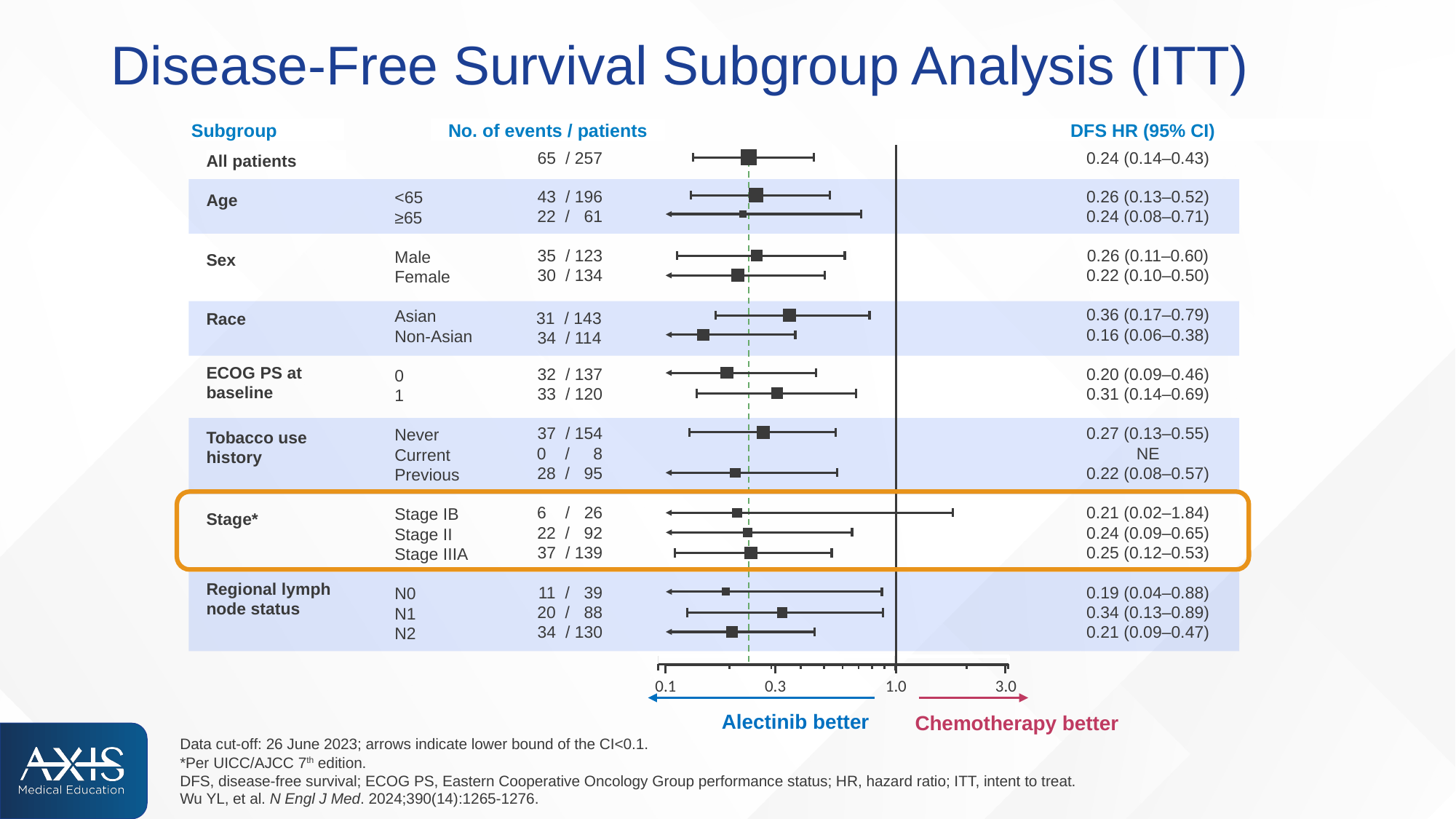
Is the DFS hazard ratio for All patients greater or less than 1.0? less What is the DFS HR (95% CI) for All patients? 0.24 (0.14–0.43) Which subgroup row is highlighted with an orange box? Stage* What is the difference between the DFS hazard ratios for the Asian and Non-Asian subgroups? 0.20 What is the total number of patients across the two Age subgroups (<65 and ≥65)? 257 Which has the larger DFS hazard ratio, ECOG PS 0 or ECOG PS 1? ECOG PS 1 What is the DFS HR (95% CI) for the Non-Asian subgroup? 0.16 (0.06–0.38) What is the number of events / patients for Stage IIIA? 37 / 139 Which subgroup has the lowest DFS hazard ratio point estimate? Non-Asian (0.16) Which subgroup has the highest DFS hazard ratio point estimate? Asian (0.36) What type of chart is shown on the slide? Forest plot How many Stage subgroups are plotted? 3